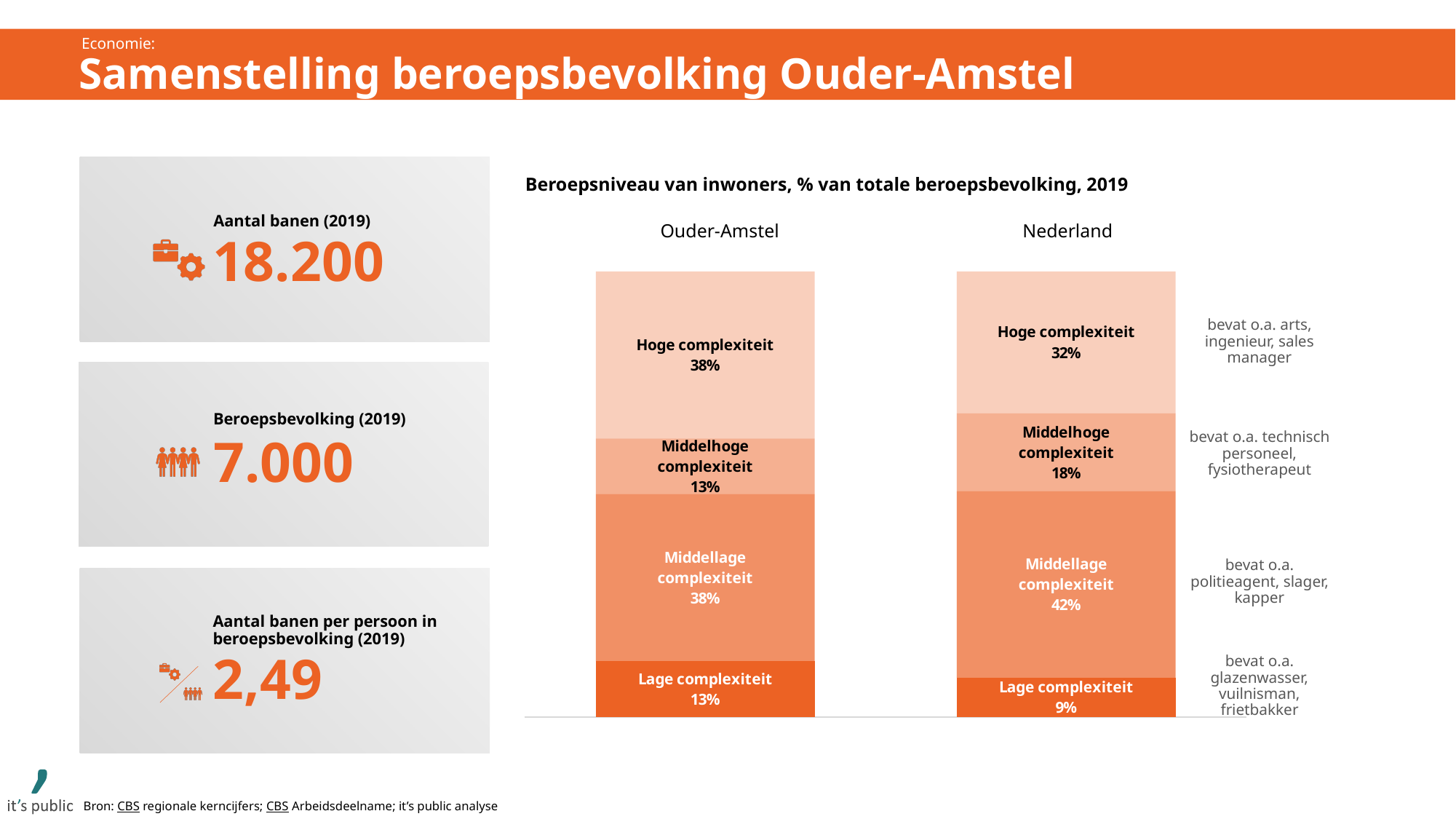
What is the title of the chart? Beroepsniveau van inwoners, % van totale beroepsbevolking, 2019 Which segment is the largest in the Nederland bar? Middellage complexiteit What is the difference in percentage points between 'Lage complexiteit' in Ouder-Amstel and in Nederland? 4 What is the value for 'Lage complexiteit' in the Nederland bar? 9% Which has a larger share of 'Middelhoge complexiteit', Ouder-Amstel or Nederland? Nederland What share of the Nederland workforce is in 'Middelhoge complexiteit'? 18% What kind of chart is shown on the slide? Stacked bar chart What is the value for 'Middellage complexiteit' in the Ouder-Amstel bar? 38% What percentage of the Ouder-Amstel workforce is in 'Hoge complexiteit'? 38% How many bars are shown in the chart? 2 How many percentage points higher is 'Hoge complexiteit' in Ouder-Amstel than in Nederland? 6 Which segment is the smallest in the Nederland bar? Lage complexiteit